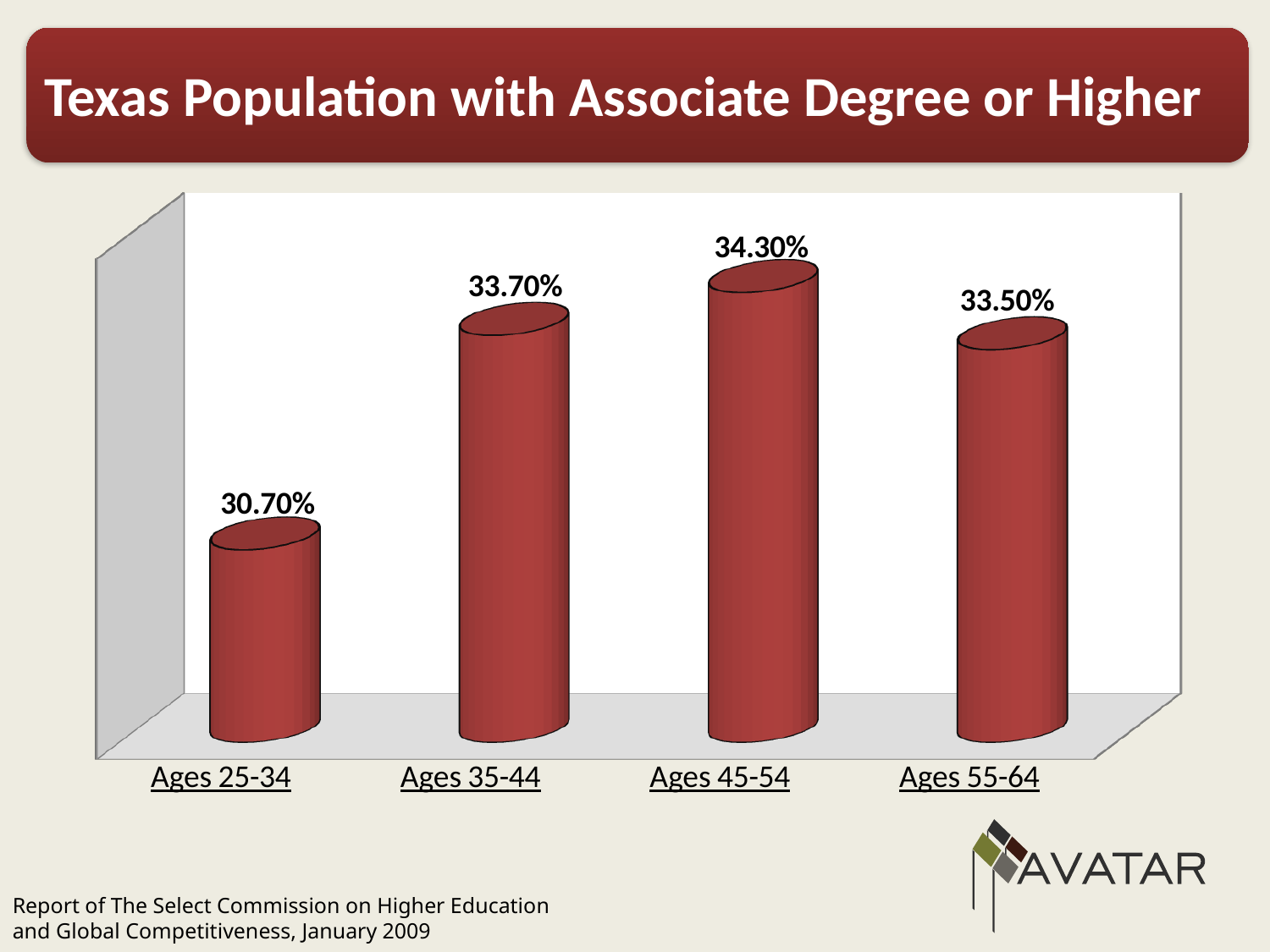
What is the difference in percentage points between Ages 45-54 and Ages 25-34? 3.60% What is the value shown for Ages 55-64? 33.50% What type of chart is shown on the slide? Bar chart What is the difference between the values for Ages 35-44 and Ages 55-64? 0.20% What is the value shown for Ages 45-54? 34.30% How many age groups are shown in the chart? 4 What is the value shown for Ages 35-44? 33.70% What is the title of the chart? Texas Population with Associate Degree or Higher Which age group has the lowest percentage with an associate degree or higher? Ages 25-34 What percentage of Texans aged 25-34 have an associate degree or higher? 30.70% Which has a higher value, Ages 35-44 or Ages 25-34? Ages 35-44 Which age group has the highest percentage with an associate degree or higher? Ages 45-54